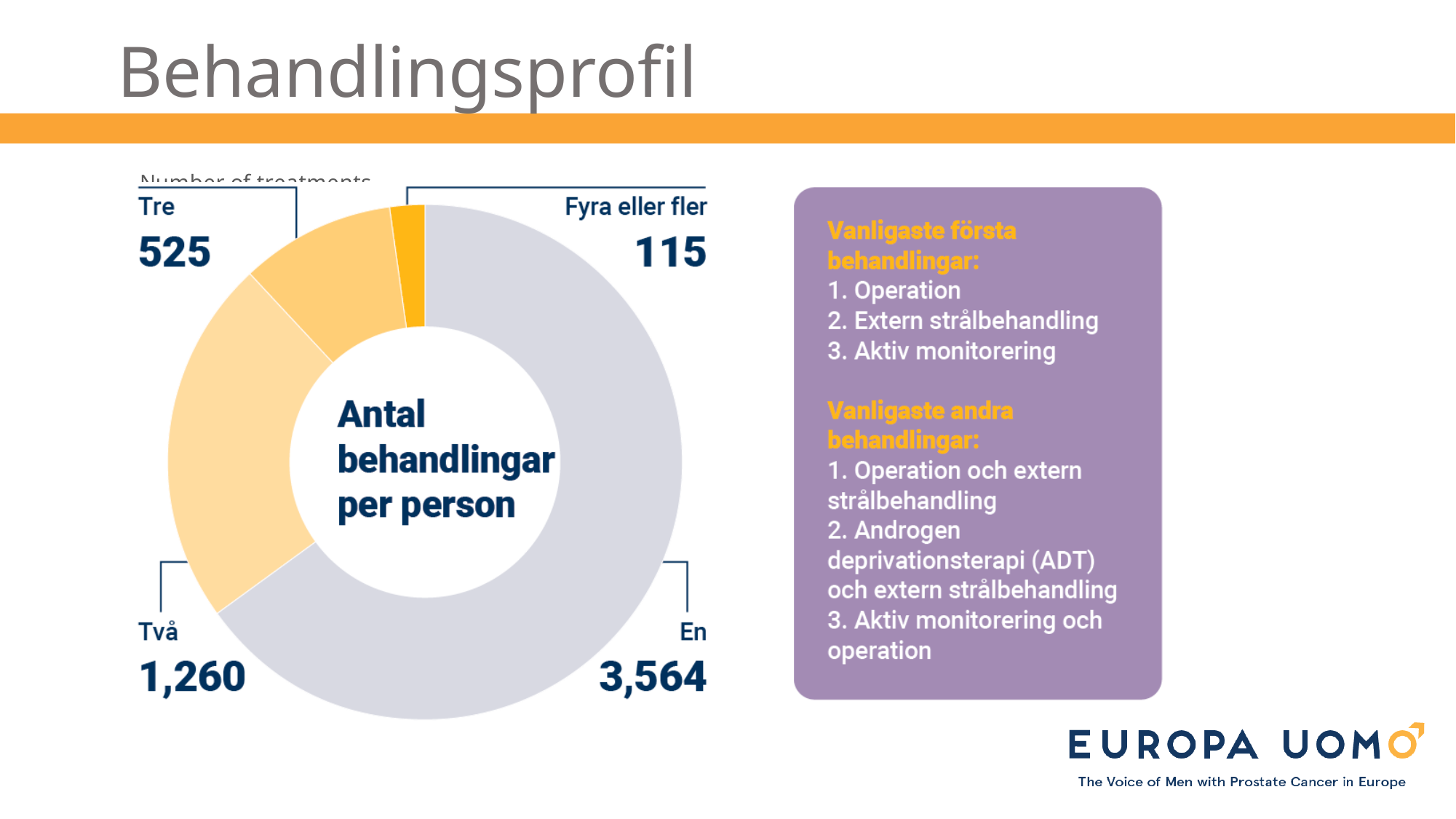
What is the value for the 'En' category in the chart? 3,564 How many categories are shown in the chart? 4 What is the value for the 'Tre' category in the chart? 525 Which is larger, the value for 'Två' or the value for 'Tre'? Två Which category has the lowest value in the chart? Fyra eller fler What is the difference between the values for 'En' and 'Två'? 2,304 What is the difference between the values for 'Tre' and 'Fyra eller fler'? 410 Which category has the highest value in the chart? En What is the value for the 'Fyra eller fler' category in the chart? 115 What kind of chart is shown on the slide? Donut (pie) chart What is the total of all the values shown in the chart? 5,464 What is the value for the 'Två' category in the chart? 1,260